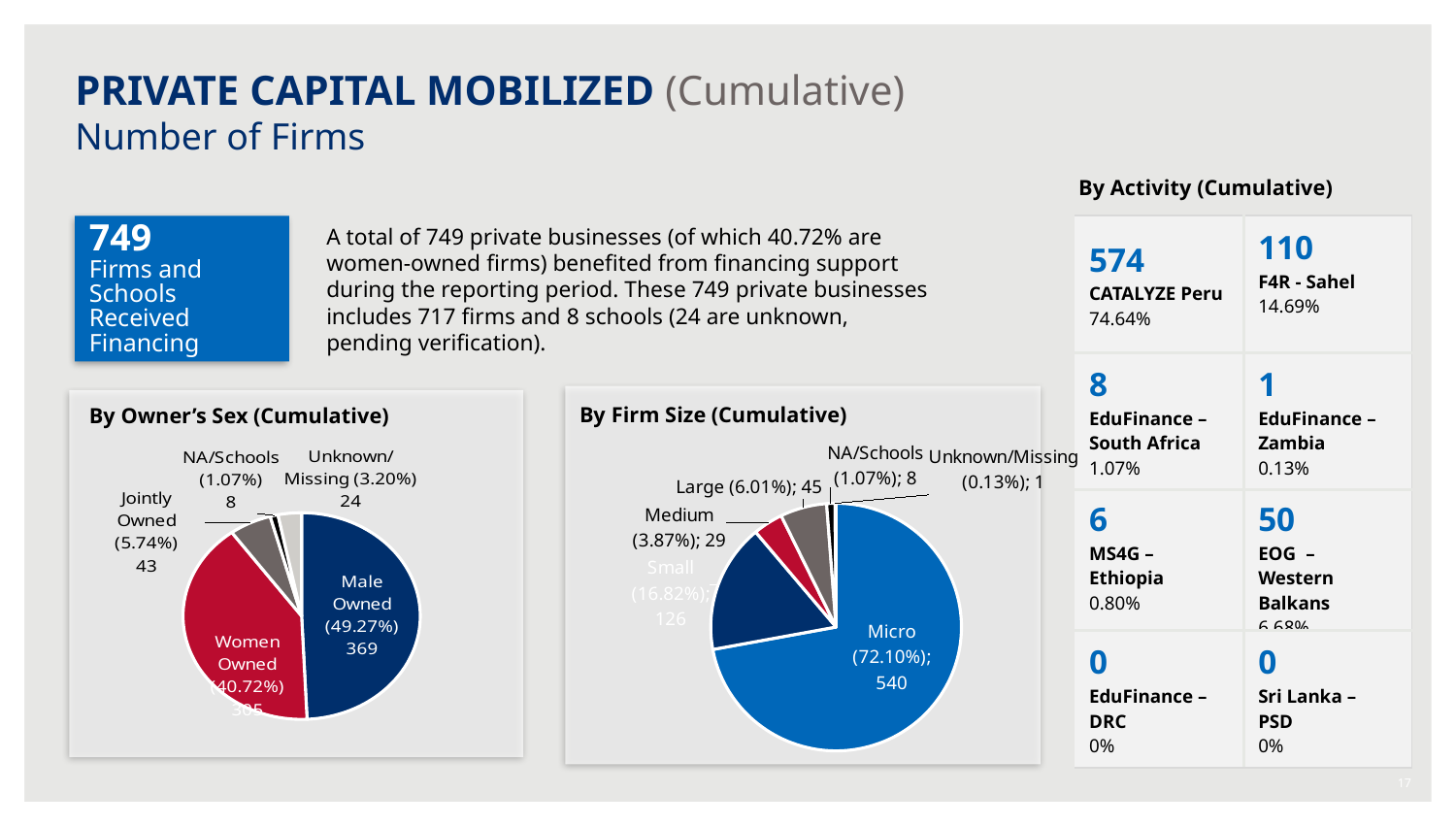
In the 'By Firm Size (Cumulative)' chart, which is larger, Large or Medium? Large In the 'By Firm Size (Cumulative)' chart, which category has the largest slice? Micro In the 'By Firm Size (Cumulative)' chart, what is the difference between the number of Large firms and Medium firms? 16 In the 'By Owner's Sex (Cumulative)' chart, how many firms are in the Unknown/Missing category? 24 In the 'By Owner's Sex (Cumulative)' chart, which category has the smallest slice? NA/Schools In the 'By Owner's Sex (Cumulative)' chart, what share of the pie is Jointly Owned? 5.74% In the 'By Owner's Sex (Cumulative)' chart, how many categories are shown? 5 In the 'By Firm Size (Cumulative)' chart, how many firms are Micro? 540 In the 'By Firm Size (Cumulative)' chart, how many categories are shown? 6 In the 'By Owner's Sex (Cumulative)' chart, how many firms are Male Owned? 369 What kind of chart is the 'By Owner's Sex (Cumulative)' chart? Pie chart In the 'By Firm Size (Cumulative)' chart, what share of the pie is Large? 6.01%